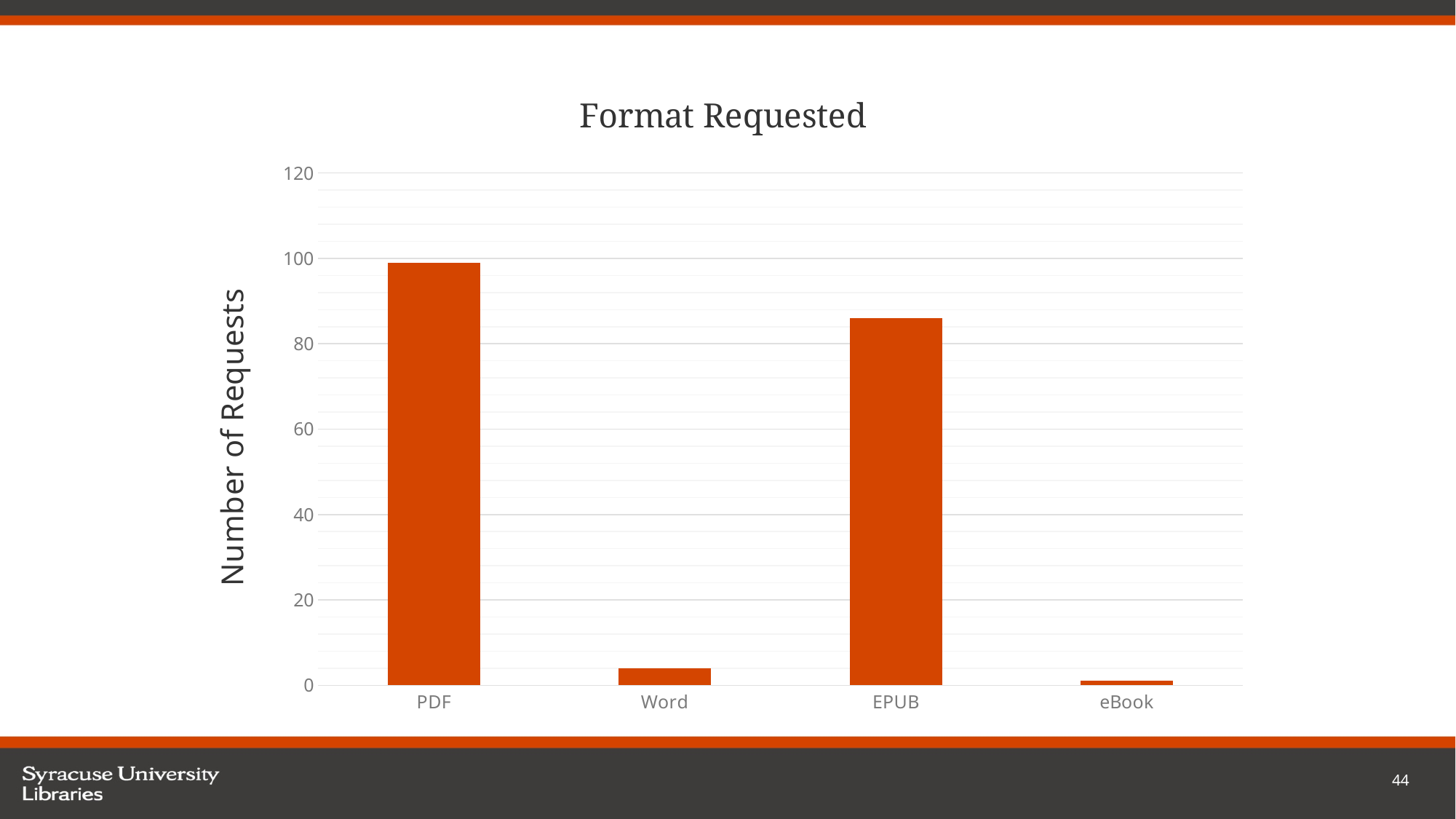
What is the label on the vertical axis? Number of Requests Is the value for EPUB greater or less than 100? less Is the value for PDF greater or less than 80? greater How many format categories are shown on the x axis? 4 Is the value for EPUB greater or less than 60? greater Which has more requests, PDF or EPUB? PDF What type of chart is shown on the slide? bar chart Which format has the highest number of requests? PDF Which format has the lowest number of requests? eBook What is the title of the chart? Format Requested Which has more requests, Word or eBook? Word